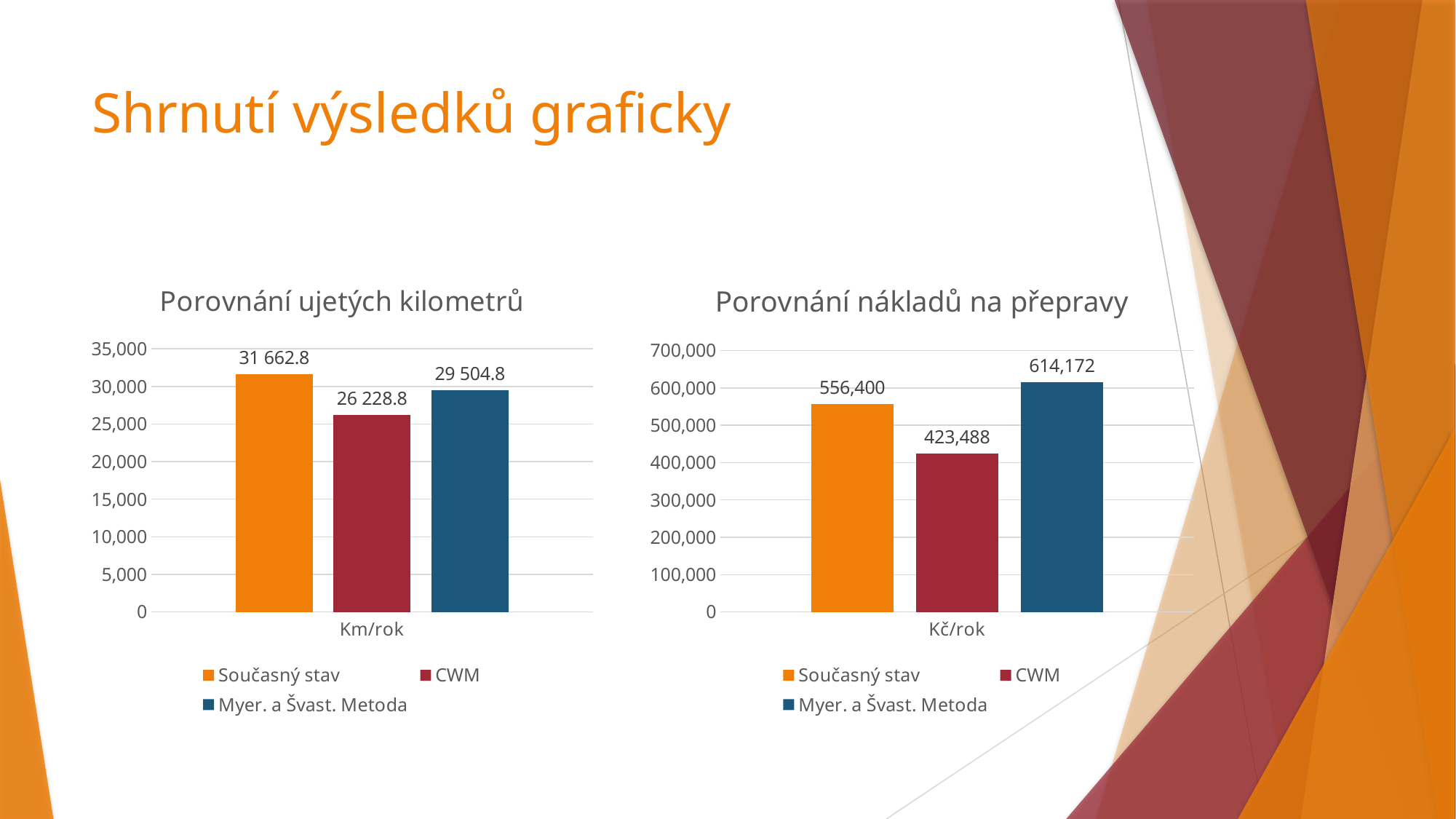
In the chart 'Porovnání ujetých kilometrů', which series has the highest value? Současný stav In the chart 'Porovnání nákladů na přepravy', which is larger, Současný stav or CWM? Současný stav In the chart 'Porovnání nákladů na přepravy', what is the value for CWM? 423,488 What kind of chart is 'Porovnání nákladů na přepravy'? Bar chart In the chart 'Porovnání nákladů na přepravy', what is the difference between Myer. a Švast. Metoda and Současný stav? 57,772 In the chart 'Porovnání ujetých kilometrů', what is the value for Současný stav? 31 662.8 In the chart 'Porovnání ujetých kilometrů', what is the value for CWM? 26 228.8 In the chart 'Porovnání ujetých kilometrů', what is the difference between Současný stav and CWM? 5 434 In the chart 'Porovnání nákladů na přepravy', which series has the highest value? Myer. a Švast. Metoda In the chart 'Porovnání nákladů na přepravy', what is the value for Myer. a Švast. Metoda? 614,172 How many series does the legend of the chart 'Porovnání ujetých kilometrů' list? 3 In the chart 'Porovnání nákladů na přepravy', which series has the lowest value? CWM